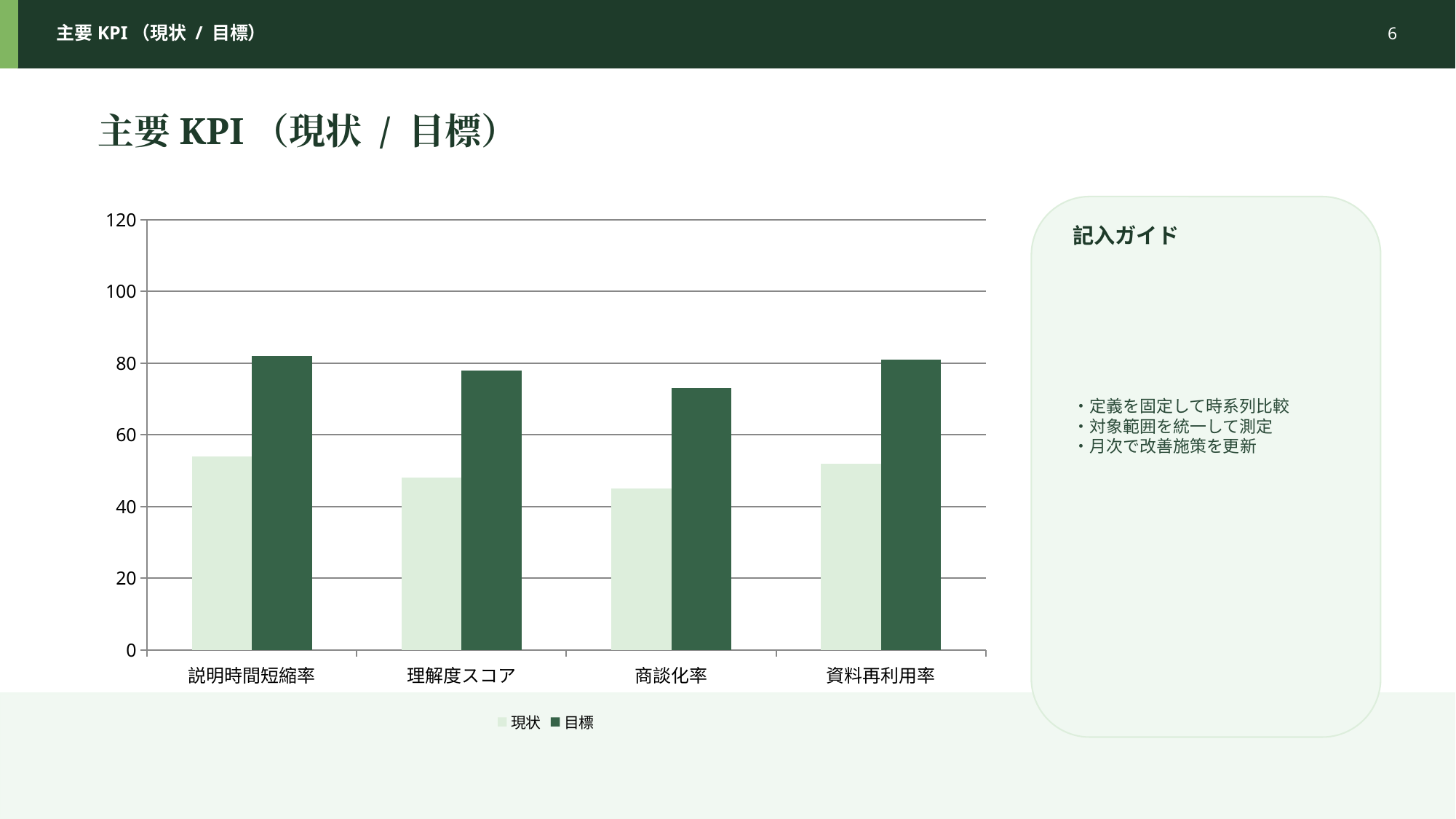
What are the two series named in the chart legend? 現状 and 目標 Which category has the lowest 目標 value? 商談化率 How many series does the chart legend list? 2 Is the 目標 value for 説明時間短縮率 greater or less than 60? greater What kind of chart is shown on the slide? bar chart Is the 現状 value for 理解度スコア greater or less than 60? less Which is larger, the 現状 value for 説明時間短縮率 or the 現状 value for 商談化率? 説明時間短縮率 Is the 現状 value for 説明時間短縮率 greater or less than 40? greater For 資料再利用率, which is larger, the 現状 value or the 目標 value? 目標 Which series is drawn in the darker green bars? 目標 How many categories are shown on the x axis of the chart? 4